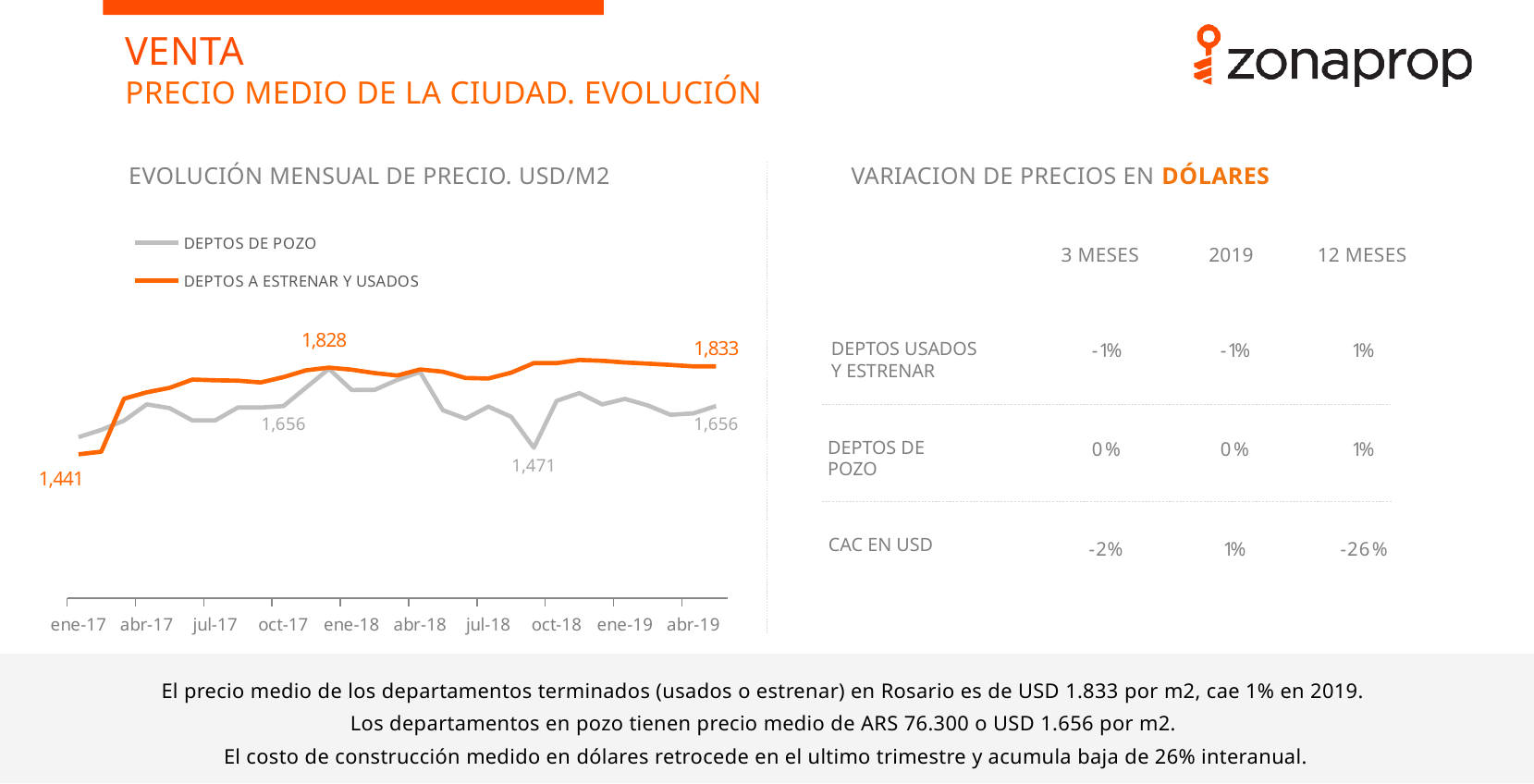
At abr-19, what is the difference between DEPTOS A ESTRENAR Y USADOS and DEPTOS DE POZO? 177 How many date labels are shown on the x axis of the line chart? 10 How many series does the legend of the line chart list? 2 What is the labeled value of DEPTOS DE POZO at abr-19? 1,656 What is the labeled peak value of DEPTOS A ESTRENAR Y USADOS around ene-18? 1,828 What type of chart is shown under 'EVOLUCIÓN MENSUAL DE PRECIO. USD/M2'? Line chart What is the labeled value of DEPTOS A ESTRENAR Y USADOS at abr-19? 1,833 What is the labeled value of DEPTOS A ESTRENAR Y USADOS at ene-17? 1,441 How much did DEPTOS A ESTRENAR Y USADOS increase from its ene-17 label (1,441) to its abr-19 label (1,833)? 392 What is the lowest labeled value on the DEPTOS DE POZO line? 1,471 At abr-19, which series has the higher value, DEPTOS DE POZO or DEPTOS A ESTRENAR Y USADOS? DEPTOS A ESTRENAR Y USADOS Does the DEPTOS A ESTRENAR Y USADOS line rise or fall overall from ene-17 to abr-19? Rise